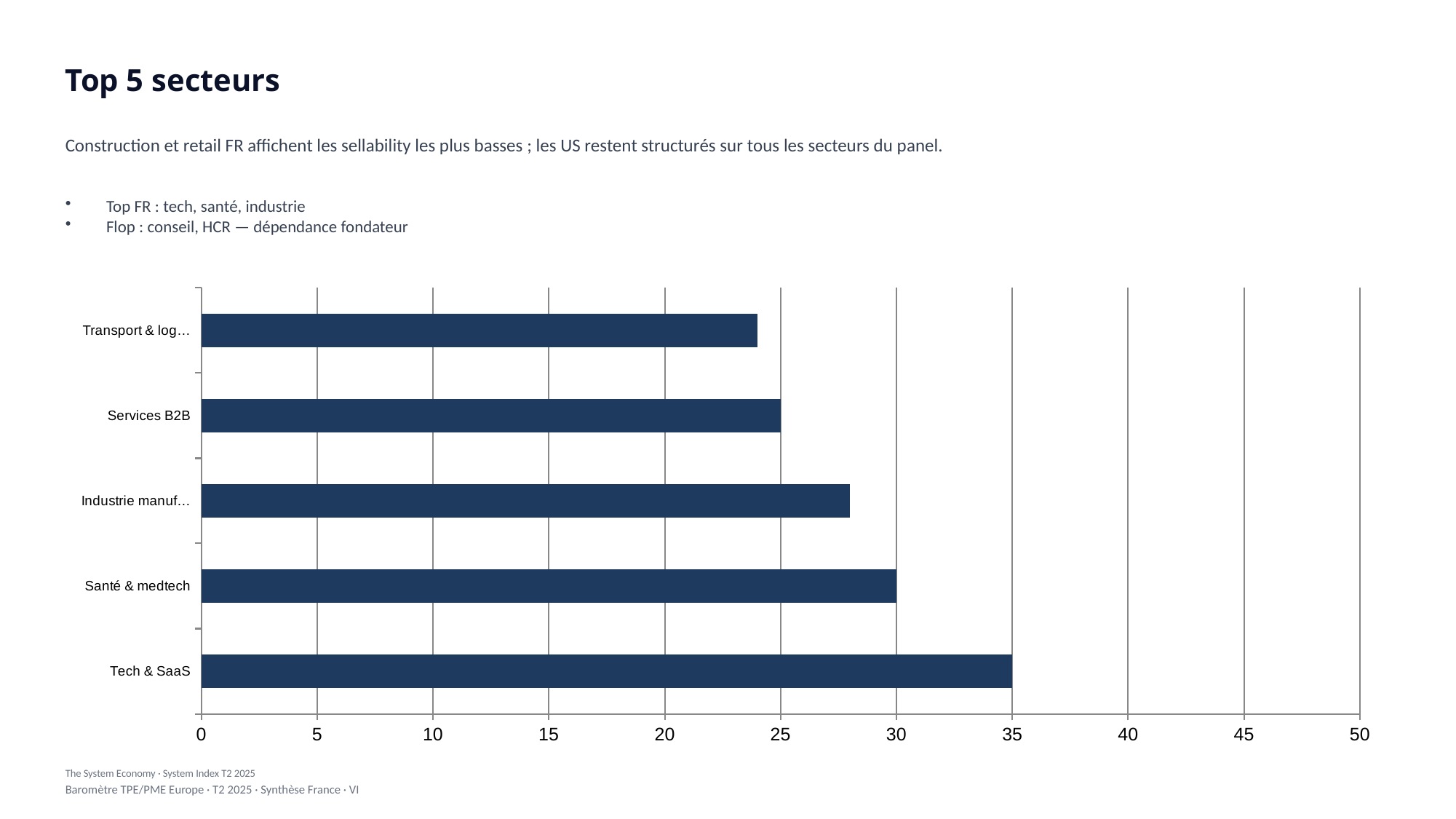
Which category has the highest value? Tech & SaaS What is the value for Santé & medtech? 30 What is the value for Services B2B? 25 Is the value for Industrie manuf… greater or less than 25? greater What is the difference between the values for Tech & SaaS and Santé & medtech? 5 What is the title of the slide containing the chart? Top 5 secteurs What is the value for Tech & SaaS? 35 Which is larger, the value for Santé & medtech or the value for Services B2B? Santé & medtech What kind of chart is shown on the slide? bar chart What is the difference between the values for Tech & SaaS and Services B2B? 10 Is the value for Transport & log… greater or less than 30? less How many categories are shown in the chart? 5